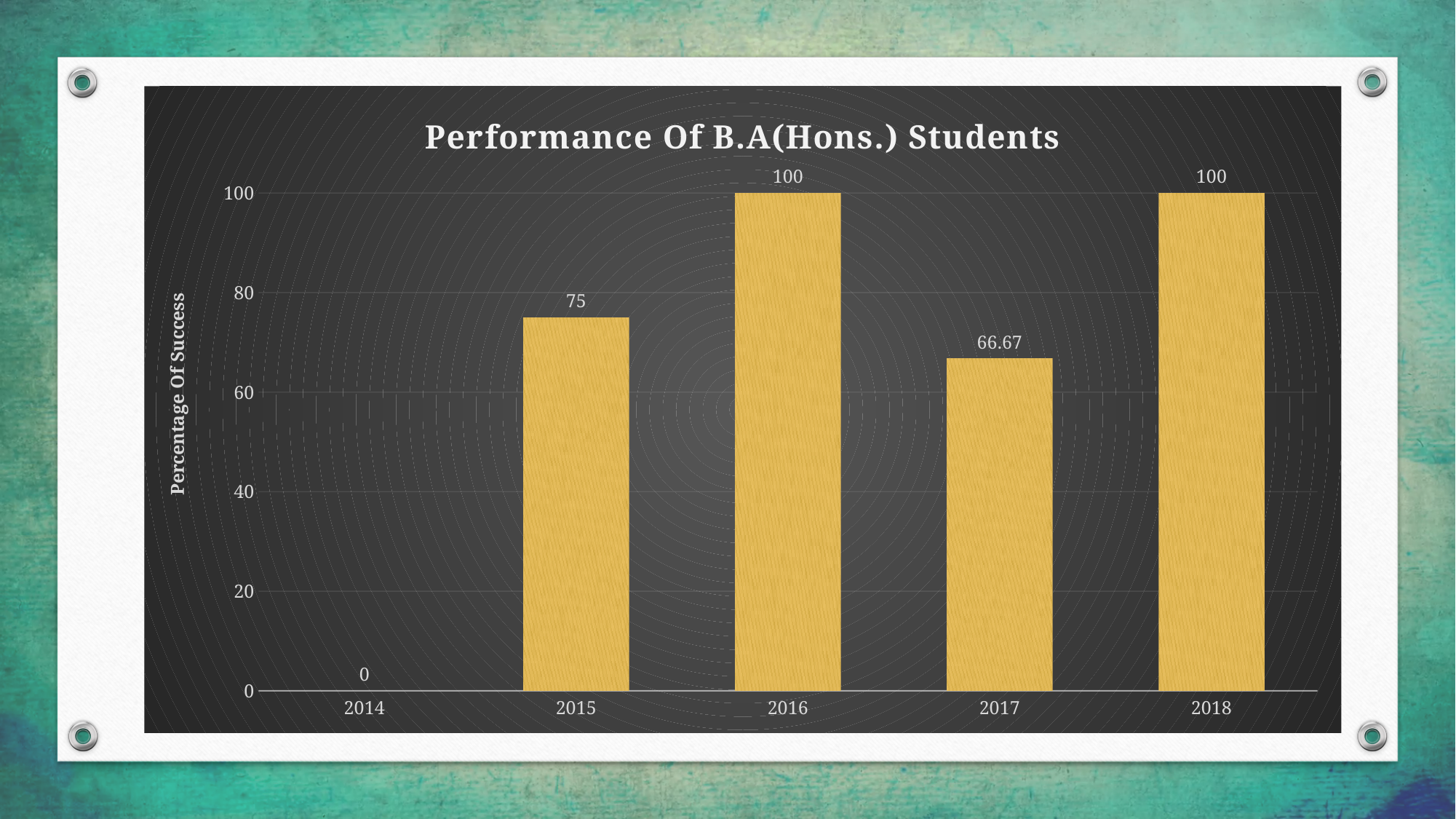
Which is larger, the value for 2015 or the value for 2017? 2015 What is the difference between the values for 2015 and 2017? 8.33 What is the value for 2016? 100 What is the label of the vertical axis? Percentage Of Success What is the difference between the values for 2016 and 2017? 33.33 What is the value for 2017? 66.67 Which year has the lowest value? 2014 What is the value for 2014? 0 What kind of chart is shown? Bar chart What is the value for 2015? 75 How many years are shown on the x axis? 5 What is the title of the chart? Performance Of B.A(Hons.) Students